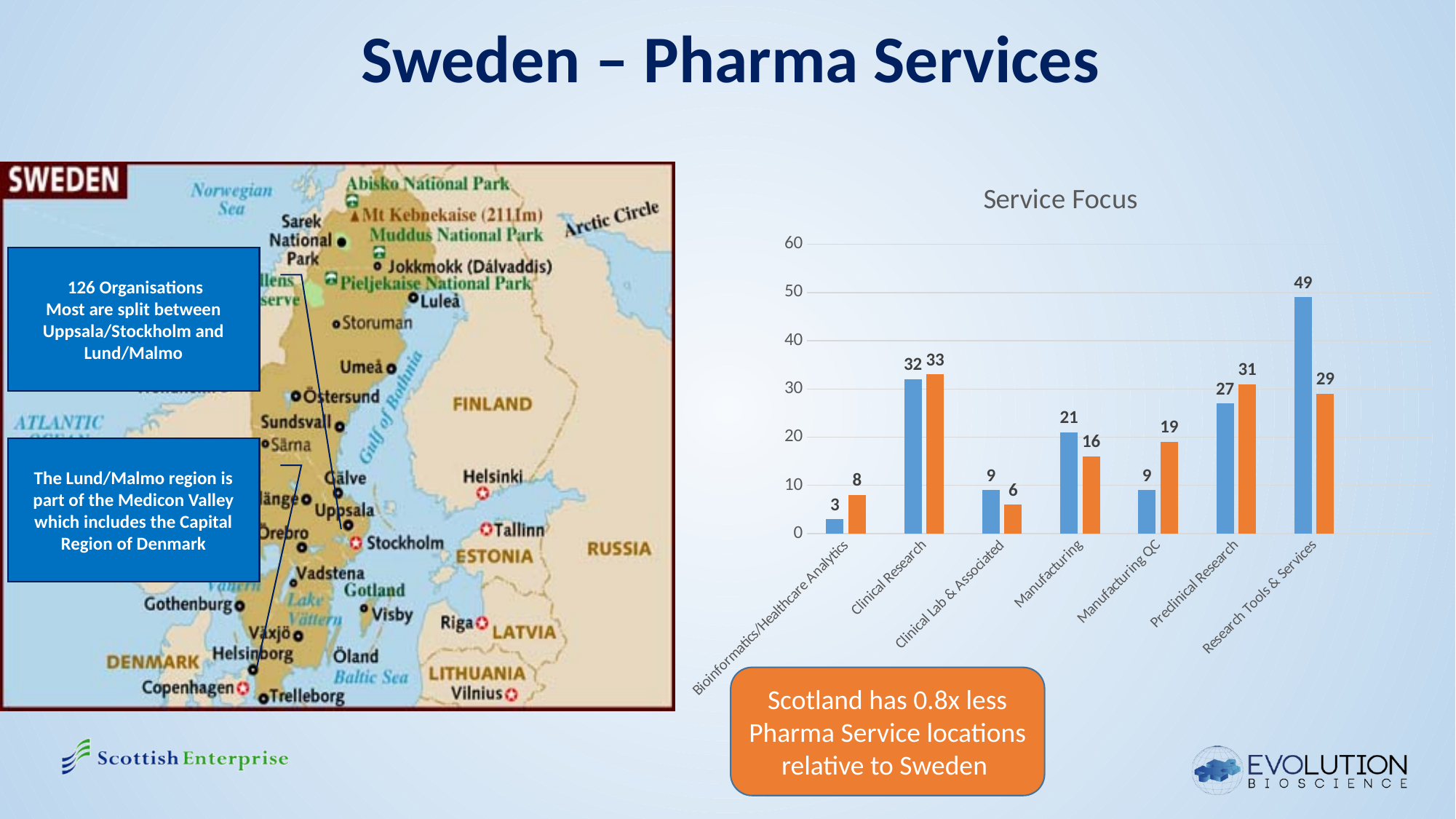
What type of chart is shown under the title 'Service Focus'? bar chart What is the value of the blue bar for Research Tools & Services? 49 Which category has the highest blue bar? Research Tools & Services What is the value of the orange bar for Manufacturing QC? 19 Which category has the lowest blue bar? Bioinformatics/Healthcare Analytics What is the title of the chart? Service Focus For Manufacturing, which is larger, the blue bar or the orange bar? the blue bar What is the value of the blue bar for Clinical Lab & Associated? 9 Which category has the lowest orange bar? Clinical Lab & Associated What is the difference between the blue and orange bars for Research Tools & Services? 20 How many categories are shown on the x axis of the Service Focus chart? 7 What is the difference between the orange bar for Preclinical Research and the orange bar for Manufacturing? 15